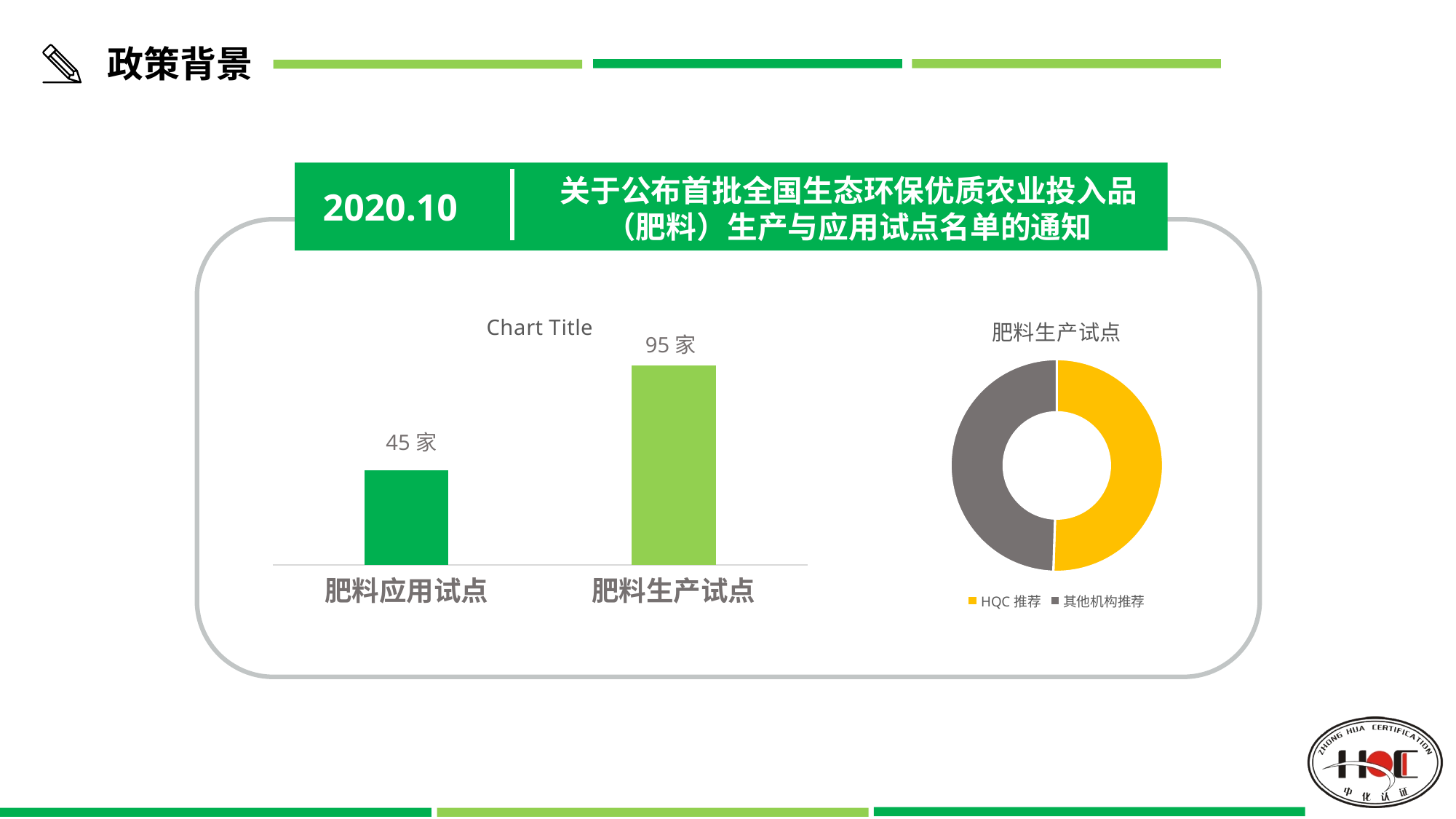
In the bar chart titled "Chart Title", what is the value for 肥料生产试点? 95 家 In the bar chart titled "Chart Title", what is the difference between the values for 肥料生产试点 and 肥料应用试点? 50 家 How many entries does the legend of the chart titled "肥料生产试点" list? 2 In the bar chart titled "Chart Title", which is larger: the value for 肥料应用试点 or the value for 肥料生产试点? 肥料生产试点 In the chart titled "肥料生产试点", which legend entry is shown in grey? 其他机构推荐 In the bar chart titled "Chart Title", which category has the highest value? 肥料生产试点 In the bar chart titled "Chart Title", which category has the lowest value? 肥料应用试点 In the bar chart titled "Chart Title", what is the value for 肥料应用试点? 45 家 What kind of chart is the chart on the right titled "肥料生产试点"? doughnut chart In the chart titled "肥料生产试点", which legend entry is shown in yellow? HQC 推荐 How many categories are shown in the bar chart titled "Chart Title"? 2 What kind of chart is the chart on the left titled "Chart Title"? bar chart